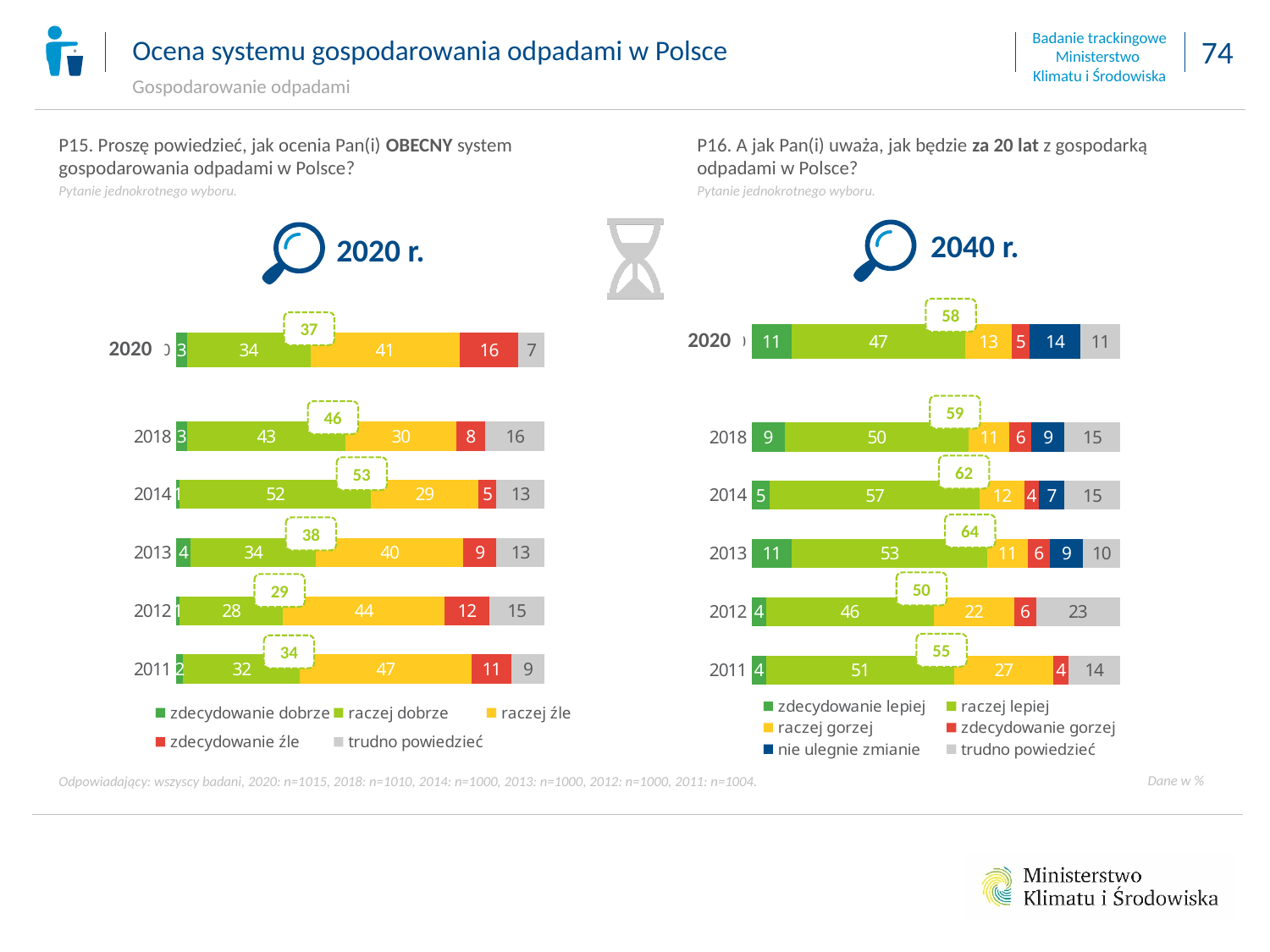
In the left chart (P15, 2020 r.), which year has the highest value for "zdecydowanie źle"? 2020 In the left chart (P15, 2020 r.), what is the value for "raczej dobrze" in 2014? 52 In the right chart (P16, 2040 r.), what value is shown in the callout above the 2013 bar? 64 How many series does the legend of the right chart (P16, 2040 r.) list? 6 In the left chart (P15, 2020 r.), what is the difference between the "raczej źle" values for 2011 and 2018? 17 How many years are shown in the left chart (P15, 2020 r.)? 6 In the right chart (P16, 2040 r.), which year has the lowest value for "raczej lepiej"? 2012 In the right chart (P16, 2040 r.), what is the value for "nie ulegnie zmianie" in 2020? 14 In the right chart (P16, 2040 r.), what is the value for "raczej lepiej" in 2018? 50 What type of chart is the left chart (P15, 2020 r.)? Stacked bar chart In the right chart (P16, 2040 r.), which is larger: the "trudno powiedzieć" value for 2012 or for 2013? 2012 In the left chart (P15, 2020 r.), what is the value for "raczej źle" in 2020? 41